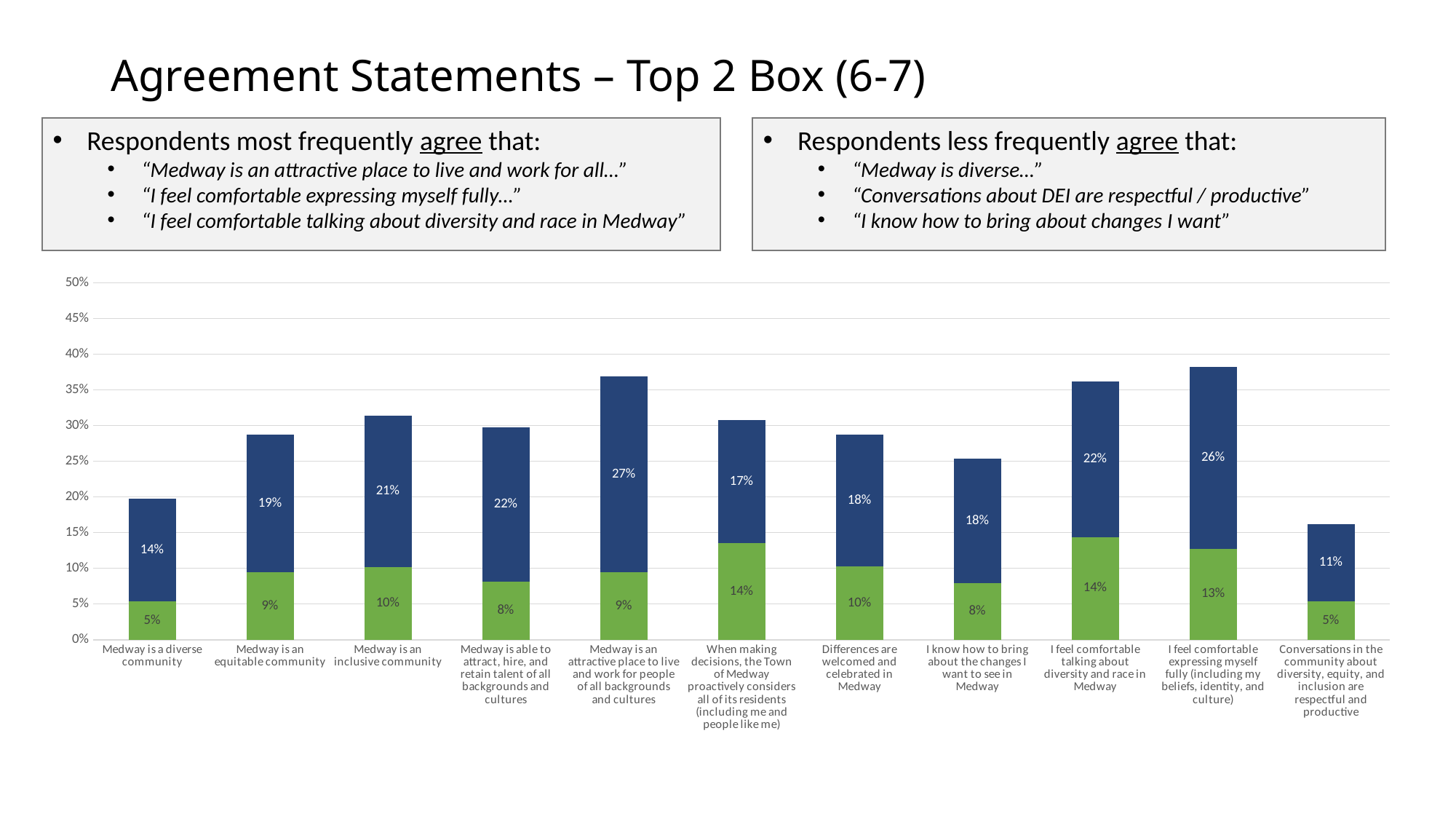
What is the total of the stacked bar for "Conversations in the community about diversity, equity, and inclusion are respectful and productive"? 16% What kind of chart is shown on the slide? Stacked bar chart Which has a larger green (lower) segment: "I feel comfortable talking about diversity and race in Medway" or "Medway is an inclusive community"? I feel comfortable talking about diversity and race in Medway Which statement has the largest blue (upper) segment? Medway is an attractive place to live and work for people of all backgrounds and cultures What is the value of the green (lower) segment for "I know how to bring about the changes I want to see in Medway"? 8% Is the total stacked bar for "I feel comfortable expressing myself fully (including my beliefs, identity, and culture)" greater or less than 35%? greater What is the value of the green (lower) segment for "When making decisions, the Town of Medway proactively considers all of its residents (including me and people like me)"? 14% For "Medway is a diverse community", how much larger is the blue segment than the green segment? 9% How many agreement statements (categories) are plotted on the chart? 11 What is the value of the blue (upper) segment for "Medway is an attractive place to live and work for people of all backgrounds and cultures"? 27% What is the highest value shown on the chart's vertical axis? 50% Which statement has the smallest blue (upper) segment? Conversations in the community about diversity, equity, and inclusion are respectful and productive